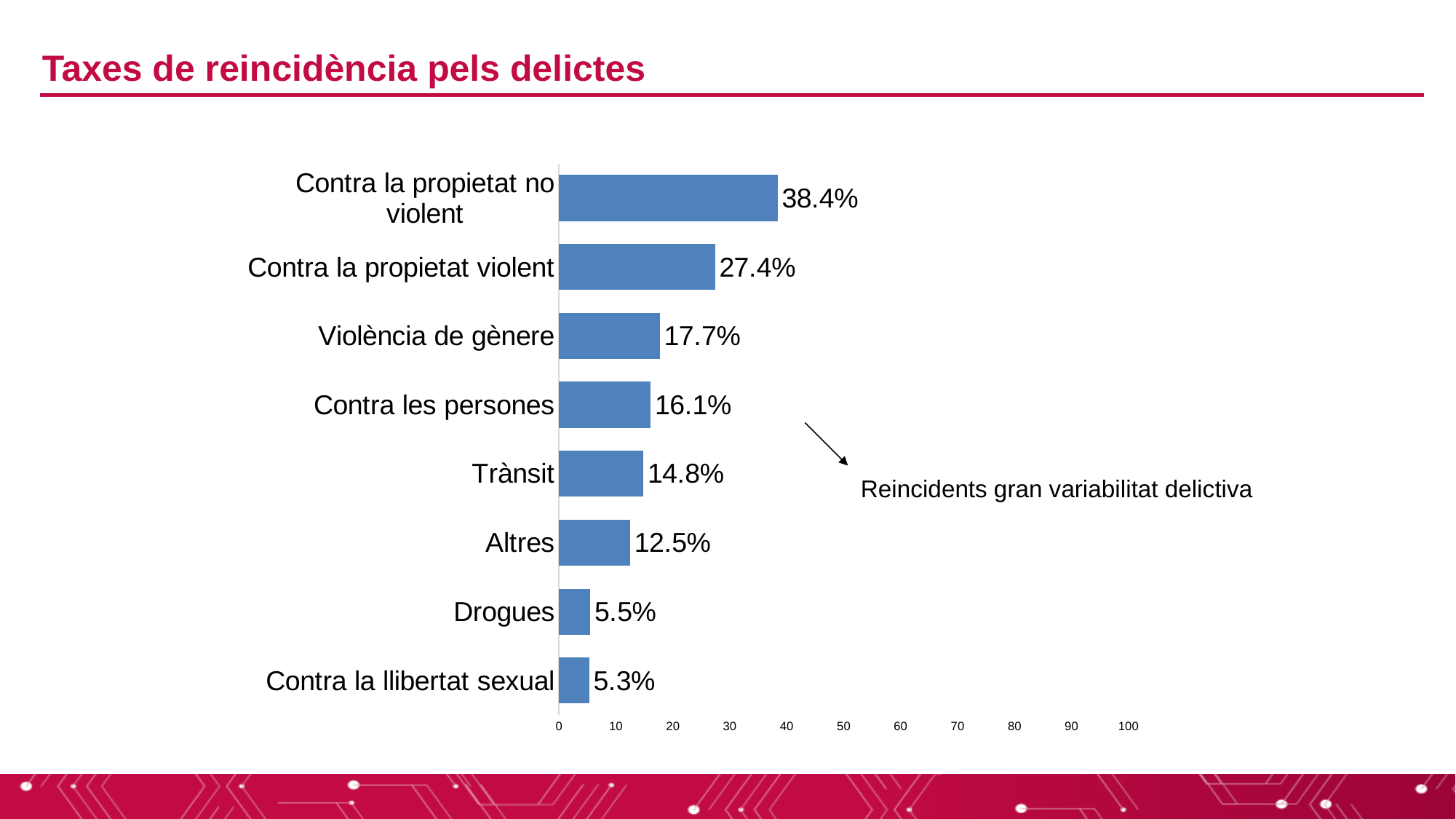
What is the recidivism rate for Violència de gènere? 17.7% Which is larger, the rate for Violència de gènere or the rate for Contra les persones? Violència de gènere What is the value shown for Trànsit? 14.8% What is the difference between the rates for Contra les persones and Altres? 3.6% Which category has the highest recidivism rate? Contra la propietat no violent What is the title of the slide containing the chart? Taxes de reincidència pels delictes Which category has the lowest recidivism rate? Contra la llibertat sexual What kind of chart is shown on the slide? Bar chart Is the value for Contra la propietat violent greater or less than 30? less What is the difference between the rates for Contra la propietat no violent and Contra la propietat violent? 11.0% What is the value shown for Drogues? 5.5% How many categories are shown in the chart? 8